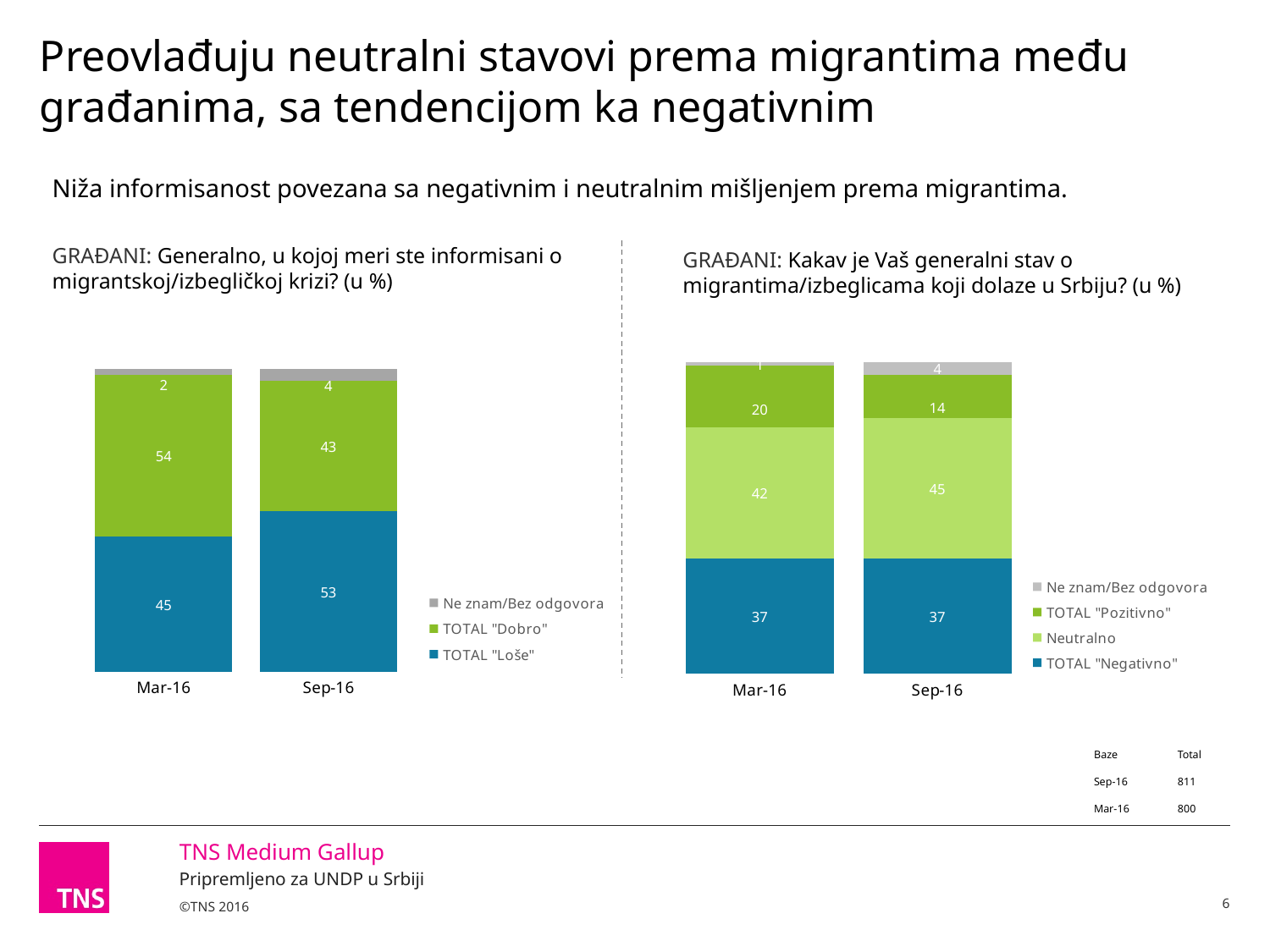
In the left chart (informisanost o migrantskoj krizi), by how much did TOTAL "Dobro" change from Mar-16 to Sep-16? 11 In the left chart (informisanost o migrantskoj krizi), what is the value for TOTAL "Dobro" in Mar-16? 54 In the right chart (generalni stav o migrantima), what is the value for Neutralno in Sep-16? 45 In the right chart (generalni stav o migrantima), which segment is the largest in the Sep-16 bar? Neutralno In the left chart (informisanost o migrantskoj krizi), what is the value for Ne znam/Bez odgovora in Sep-16? 4 In the left chart (informisanost o migrantskoj krizi), what is the total of the Sep-16 stacked bar? 100 In the left chart (informisanost o migrantskoj krizi), what is the value for TOTAL "Loše" in Sep-16? 53 In the right chart (generalni stav o migrantima), what is the difference in TOTAL "Pozitivno" between Mar-16 and Sep-16? 6 What type of chart is the left chart (informisanost o migrantskoj krizi)? Stacked bar chart In the right chart (generalni stav o migrantima), what is the value for TOTAL "Pozitivno" in Mar-16? 20 In the left chart (informisanost o migrantskoj krizi), which is larger in Sep-16: TOTAL "Loše" or TOTAL "Dobro"? TOTAL "Loše" How many series does the legend of the right chart (generalni stav o migrantima) list? 4